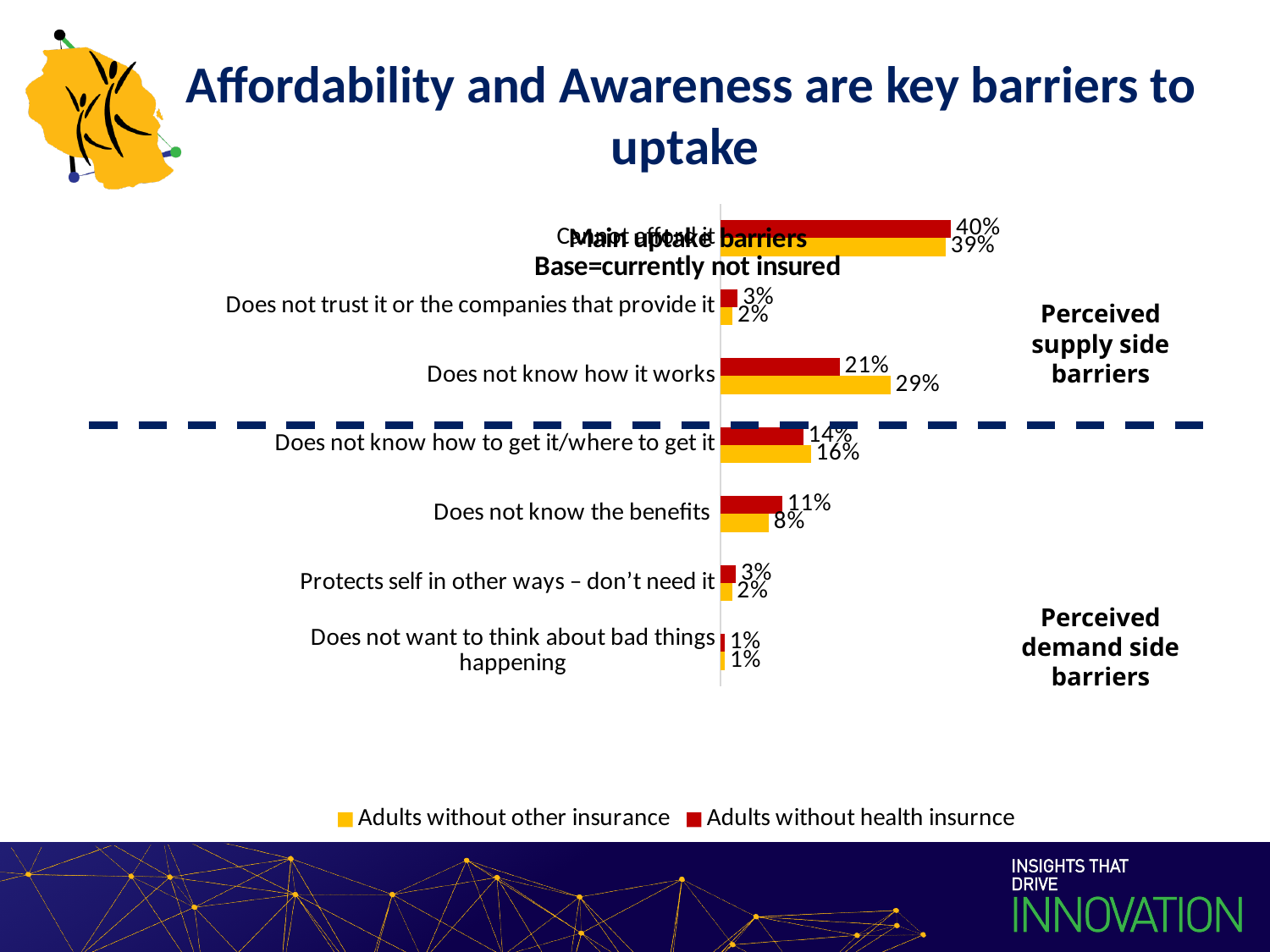
How many barrier categories are shown in the chart? 7 What is the value for 'Does not trust it or the companies that provide it' for Adults without health insurance? 3% Which colour represents Adults without health insurance in the chart? Red What is the value for 'Does not know the benefits' for Adults without health insurance? 11% For 'Does not know the benefits', which series has the larger value? Adults without health insurance What is the difference between the two series for 'Does not know how it works'? 8 percentage points What kind of chart is shown on the slide? Bar chart What is the value for 'Does not know how it works' for Adults without health insurance? 21% Which category has the lowest value for Adults without other insurance? Does not want to think about bad things happening How many series does the legend list? 2 What is the value for 'Does not know how to get it/where to get it' for Adults without other insurance? 16% What is the value for 'Does not know how it works' for Adults without other insurance? 29%